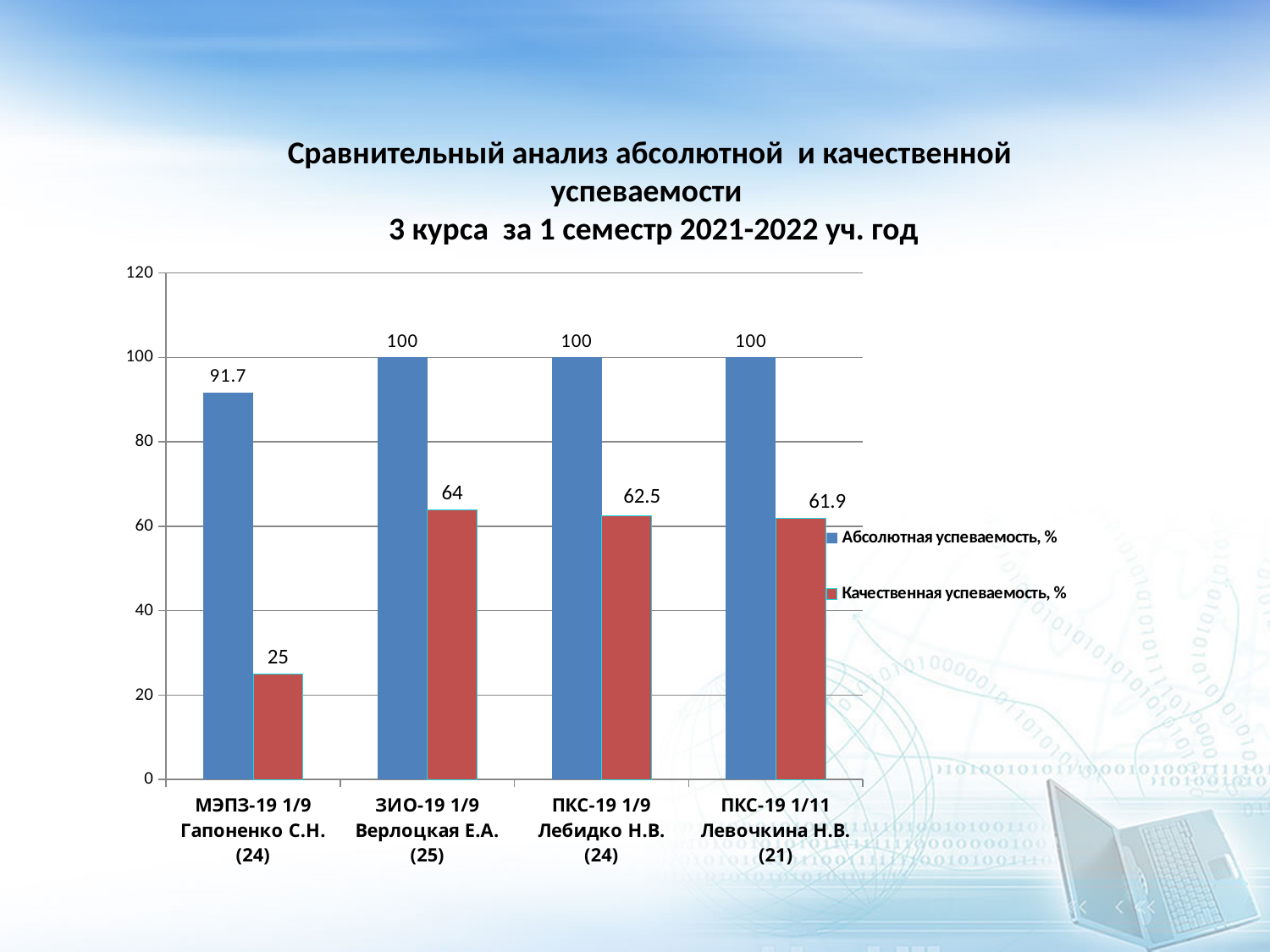
What is the value of Абсолютная успеваемость, % for МЭПЗ-19 1/9 Гапоненко С.Н. (24)? 91.7 Which group has the lowest Качественная успеваемость, %? МЭПЗ-19 1/9 Гапоненко С.Н. (24) Is the value of Качественная успеваемость, % for МЭПЗ-19 1/9 Гапоненко С.Н. (24) greater or less than 40? less What is the value of Качественная успеваемость, % for ПКС-19 1/11 Левочкина Н.В. (21)? 61.9 What is the difference between Абсолютная успеваемость, % and Качественная успеваемость, % for ПКС-19 1/9 Лебидко Н.В. (24)? 37.5 How many series does the legend list? 2 What is the value of Качественная успеваемость, % for ЗИО-19 1/9 Верлоцкая Е.А. (25)? 64 Which is larger: Качественная успеваемость, % for ЗИО-19 1/9 Верлоцкая Е.А. (25) or for ПКС-19 1/9 Лебидко Н.В. (24)? ЗИО-19 1/9 Верлоцкая Е.А. (25) How many groups are shown on the x axis? 4 What kind of chart is shown on the slide? bar chart Which group has the highest Качественная успеваемость, %? ЗИО-19 1/9 Верлоцкая Е.А. (25) Which colour represents Качественная успеваемость, % in the chart? red